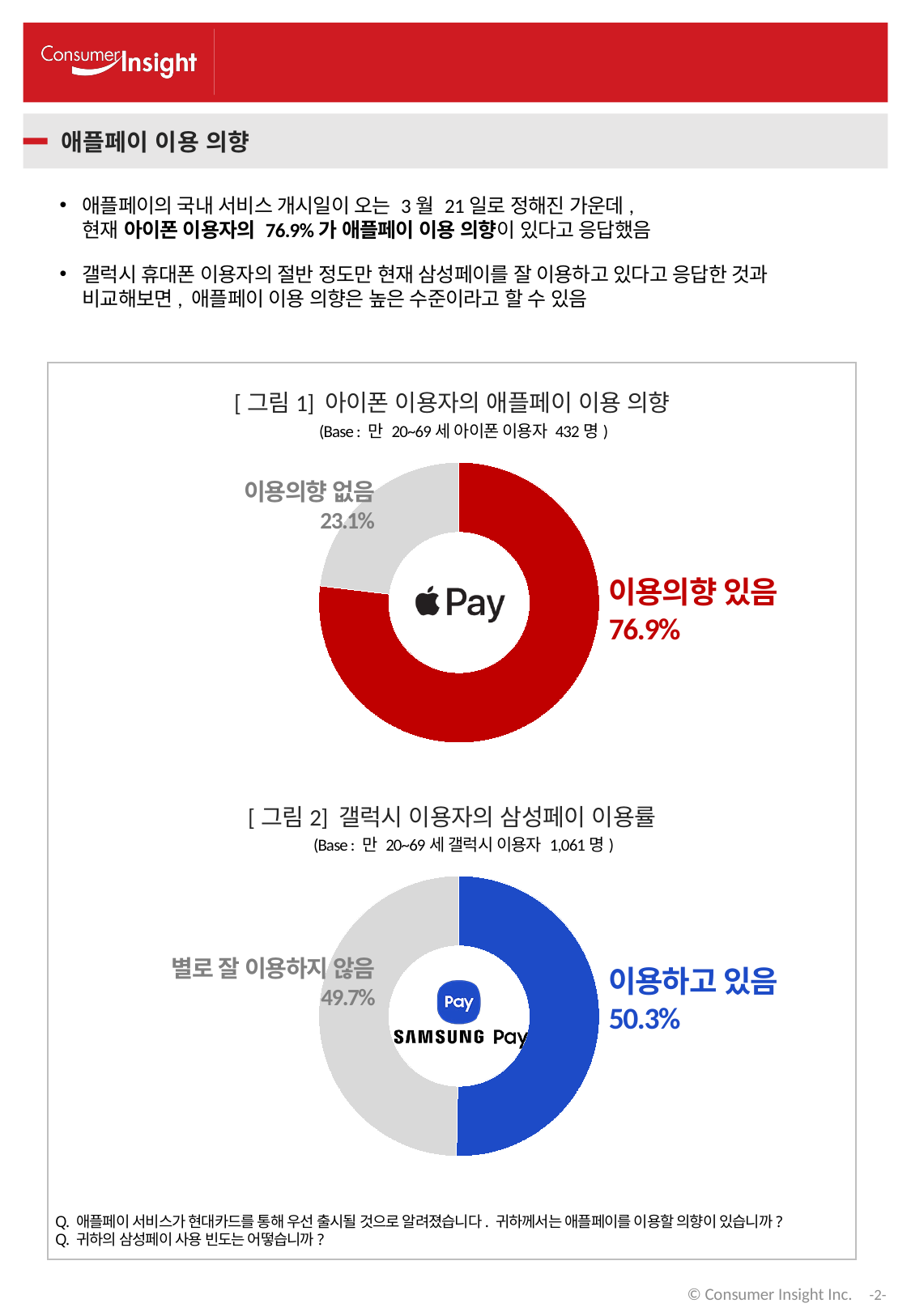
In [그림 1] 아이폰 이용자의 애플페이 이용 의향, what is the difference between 이용의향 있음 and 이용의향 없음? 53.8% In [그림 2] 갤럭시 이용자의 삼성페이 이용률, what is the value for 이용하고 있음? 50.3% In [그림 2] 갤럭시 이용자의 삼성페이 이용률, what is the difference between 이용하고 있음 and 별로 잘 이용하지 않음? 0.6% How many categories are shown in [그림 1] 아이폰 이용자의 애플페이 이용 의향? 2 What is the base (sample size) stated under [그림 2] 갤럭시 이용자의 삼성페이 이용률? 만 20~69세 갤럭시 이용자 1,061명 In [그림 2] 갤럭시 이용자의 삼성페이 이용률, what is the value for 별로 잘 이용하지 않음? 49.7% In [그림 1] 아이폰 이용자의 애플페이 이용 의향, what is the value for 이용의향 없음? 23.1% What kind of chart is [그림 2] 갤럭시 이용자의 삼성페이 이용률? Donut (pie) chart In [그림 1] 아이폰 이용자의 애플페이 이용 의향, which category has the smallest share? 이용의향 없음 In [그림 1] 아이폰 이용자의 애플페이 이용 의향, what is the value for 이용의향 있음? 76.9% In [그림 1] 아이폰 이용자의 애플페이 이용 의향, which category has the largest share? 이용의향 있음 In [그림 1] 아이폰 이용자의 애플페이 이용 의향, which is larger, 이용의향 있음 or 이용의향 없음? 이용의향 있음